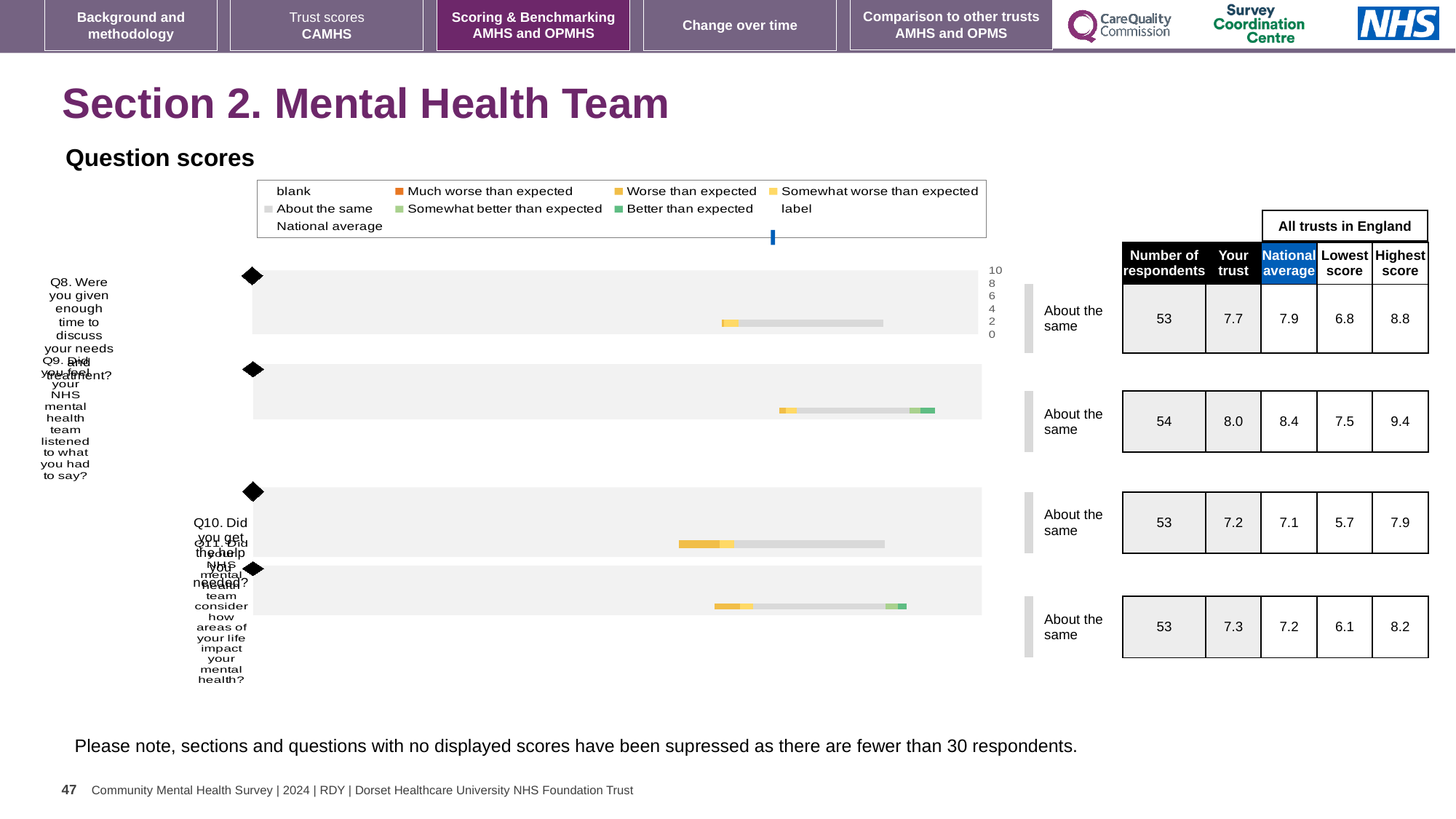
In the table beside the charts, what is the 'Your trust' score for Q8? 7.7 What kind of chart is used to show the question scores on this slide? bar chart Which question has the lowest value in the 'Lowest score' column of the table? Q10 Which question has the highest 'Your trust' score in the table? Q9 For Q10, what is the difference between the highest score (7.9) and the lowest score (5.7) in the table? 2.2 How many questions (Q8 to Q11) are plotted in the question scores charts? 4 How many entries does the legend above the question scores charts list? 9 For Q9, which is larger: the 'Your trust' score or the national average? National average In the table beside the charts, how many respondents are listed for Q9? 54 In the table beside the charts, what is the national average for Q9? 8.4 What benchmark category is shown next to the Q8 chart? About the same What colour does the legend use for 'Much worse than expected'? orange